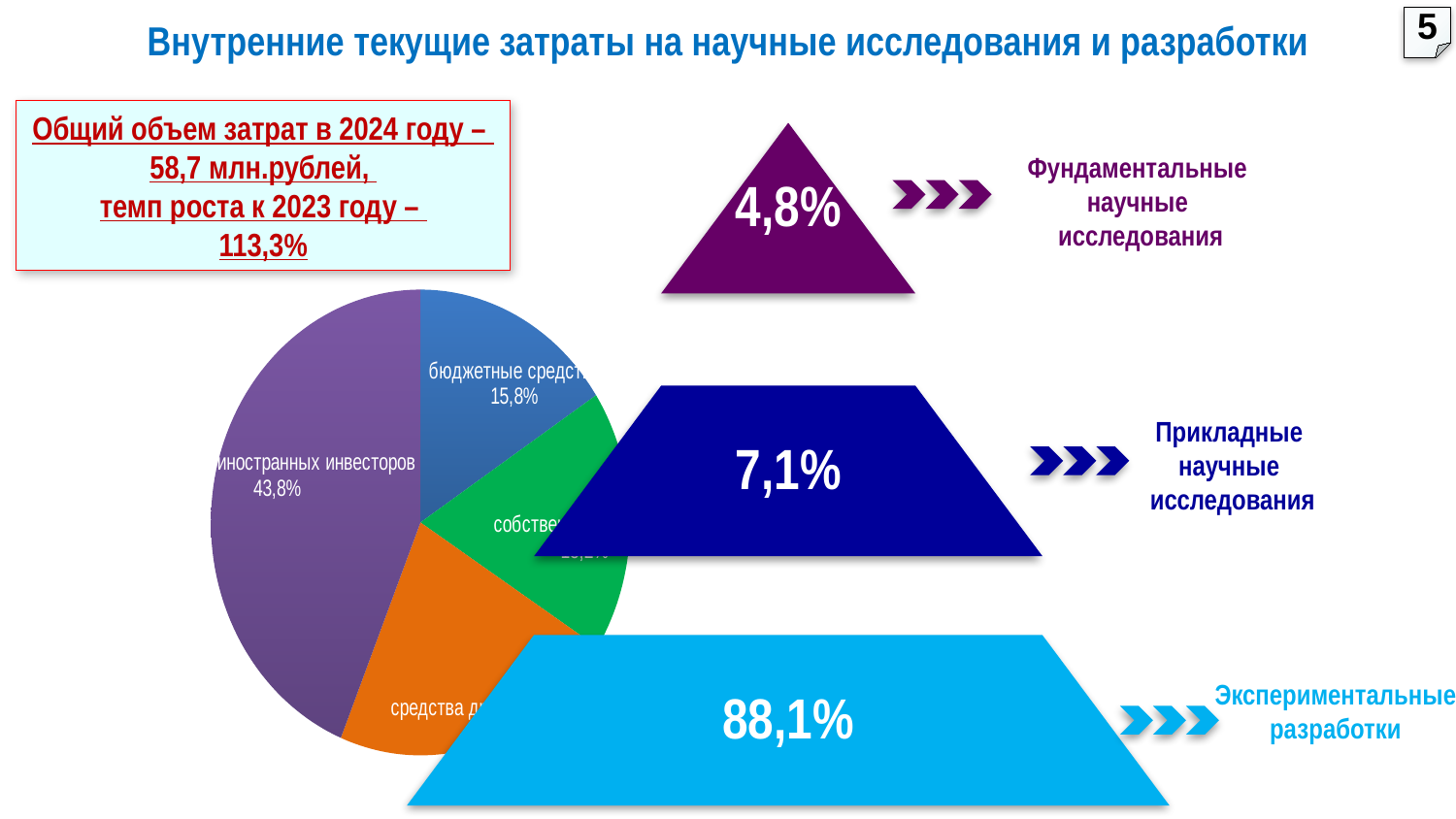
Which slice of the pie chart is the largest? иностранных инвесторов How many slices does the pie chart have? 4 What colour is the "иностранных инвесторов" slice in the pie chart? purple Is the "иностранных инвесторов" slice of the pie chart greater or less than 50%? less What colour is the "бюджетные средства" slice in the pie chart? blue In the pie chart, what share is shown for the "иностранных инвесторов" slice? 43,8% In the pyramid diagram on the right, what percentage is shown for "Фундаментальные научные исследования"? 4,8% In the pie chart, what share is shown for "бюджетные средства"? 15,8% In the pie chart, what is the difference between the "иностранных инвесторов" share and the "бюджетные средства" share? 28,0% In the pyramid diagram on the right, what percentage is shown for "Экспериментальные разработки"? 88,1% What type of chart is shown on the left of the slide? pie chart In the pie chart, which is larger: "бюджетные средства" or "иностранных инвесторов"? иностранных инвесторов